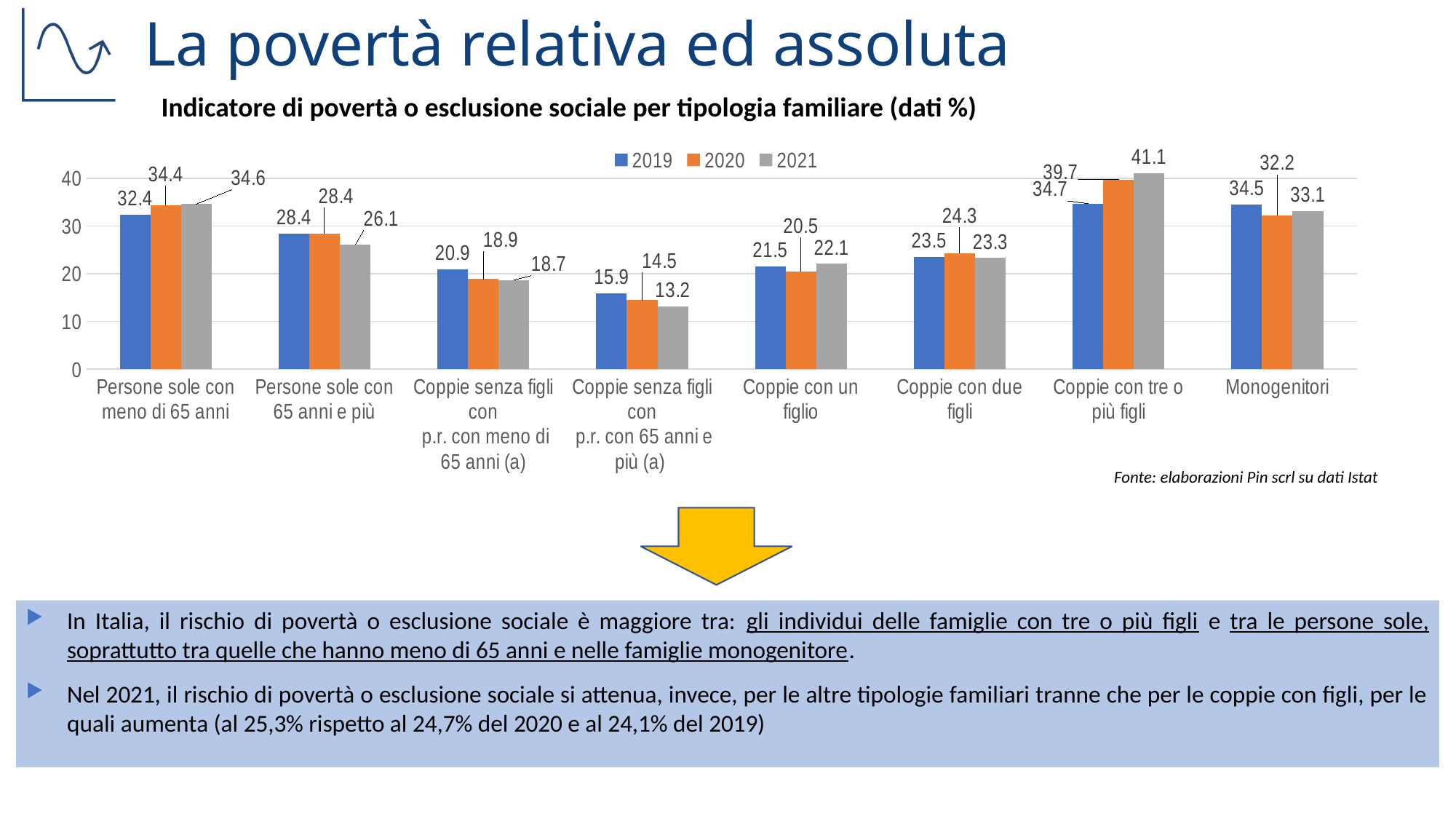
What is the 2020 value for Coppie con tre o più figli? 39.7 Which family type has the lowest value in 2019? Coppie senza figli con p.r. con 65 anni e più (a) How many series does the legend list? 3 What is the title of the chart? Indicatore di povertà o esclusione sociale per tipologia familiare (dati %) Which family type has the highest value in 2021? Coppie con tre o più figli For Coppie senza figli con p.r. con meno di 65 anni (a), do the values rise or fall from 2019 to 2021? Fall What is the 2019 value for Coppie senza figli con p.r. con 65 anni e più (a)? 15.9 What is the value for Monogenitori in 2021? 33.1 What is the difference between the 2021 and 2019 values for Coppie con tre o più figli? 6.4 Which is larger for Persone sole con 65 anni e più: the 2019 value or the 2021 value? 2019 What kind of chart is shown on the slide? Bar chart How many family types are shown on the x axis? 8